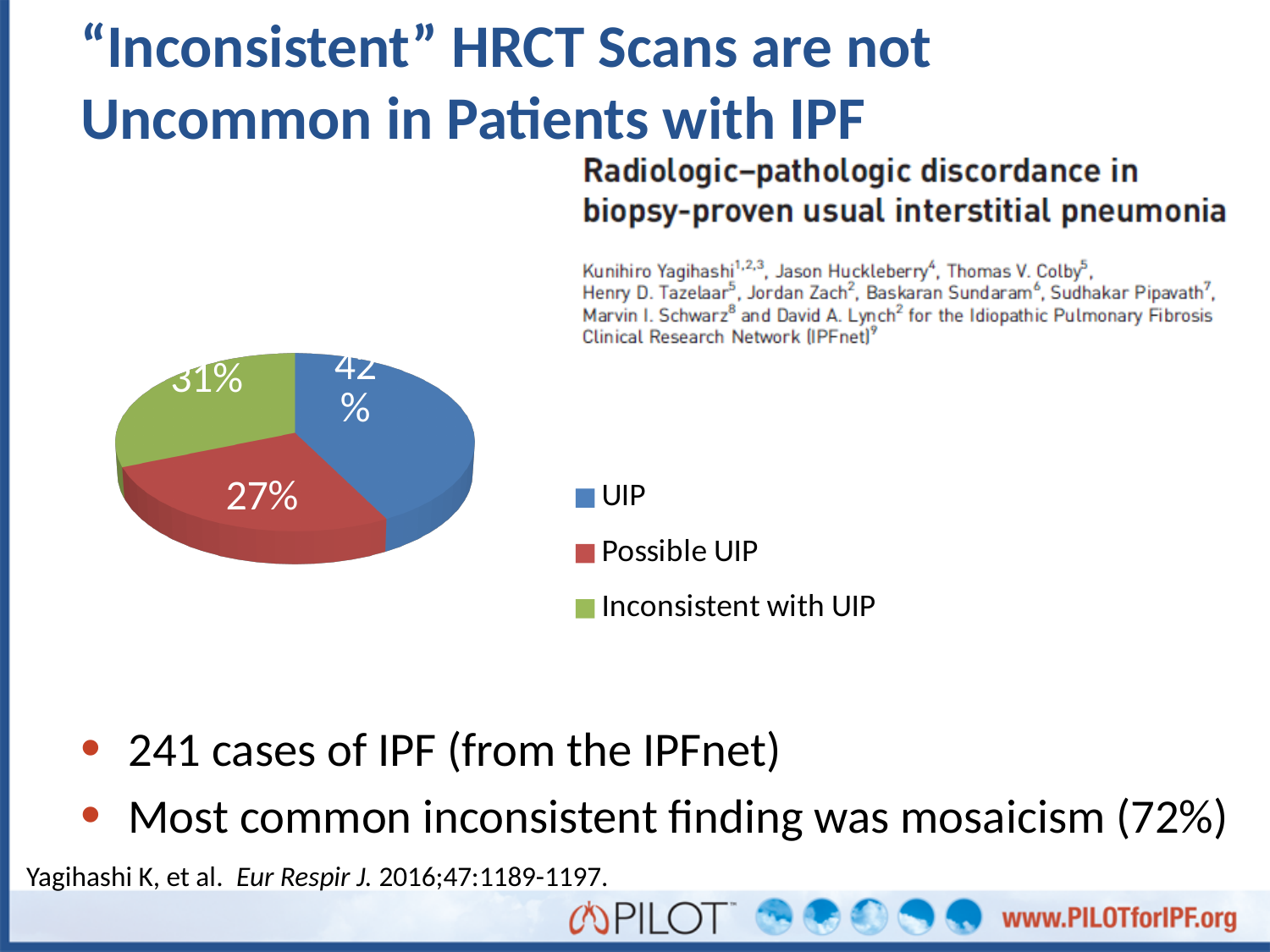
What share of the pie is labelled UIP? 42% What kind of chart is shown on the slide? pie chart What is the difference in percentage points between the UIP slice and the Possible UIP slice? 15 How many entries does the legend list? 3 Which category has the smallest slice of the pie? Possible UIP Which category has the largest slice of the pie? UIP What colour is the slice for UIP? blue Which slice is larger, Inconsistent with UIP or Possible UIP? Inconsistent with UIP How many slices does the pie chart have? 3 What colour is the slice for Inconsistent with UIP? green What share of the pie is labelled Possible UIP? 27% What share of the pie is labelled Inconsistent with UIP? 31%